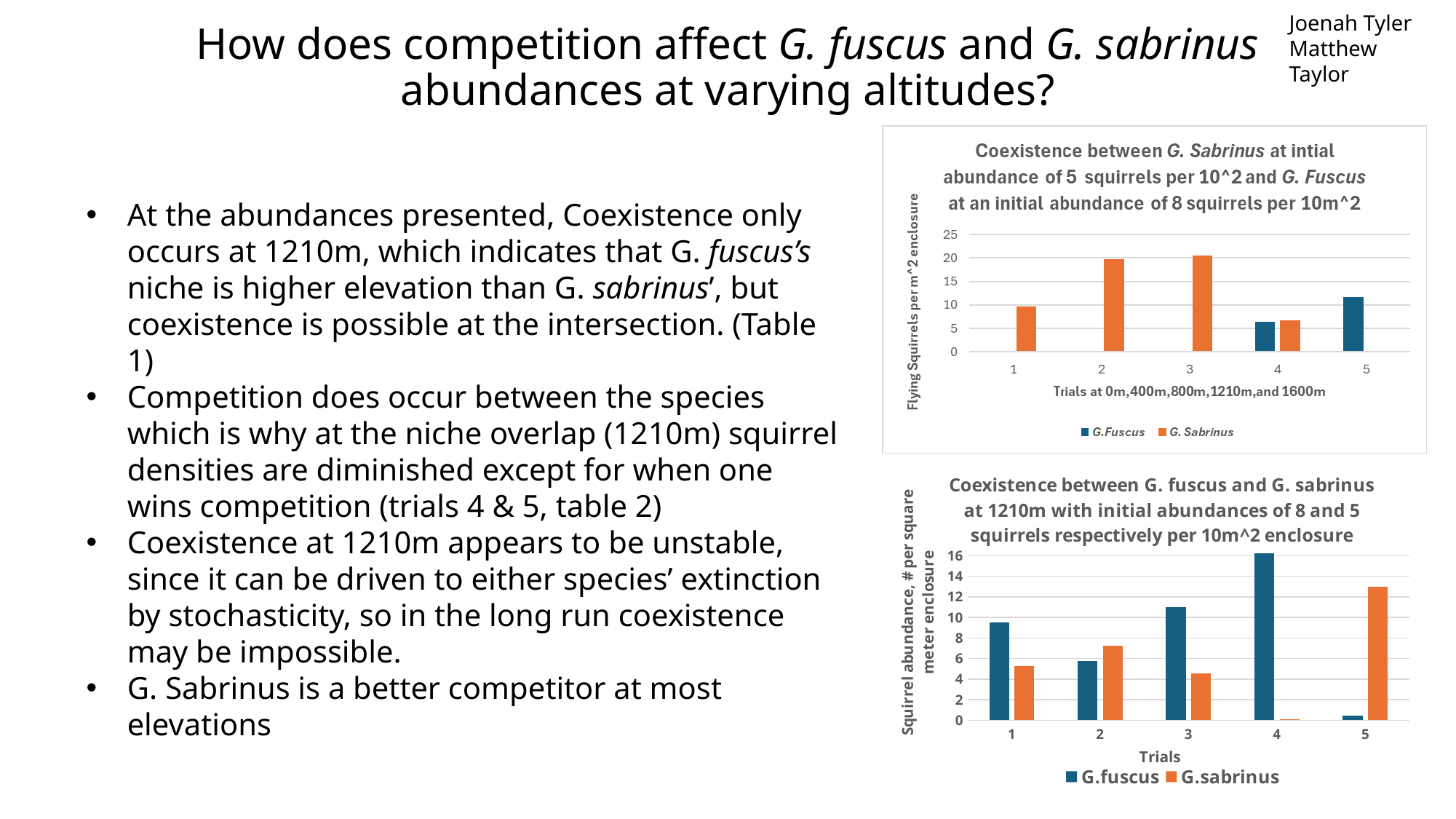
In the top chart, is the value for G. Sabrinus at trial 2 greater or less than 15? greater In the top chart, which trial has the highest G. Sabrinus value? 3 In the bottom chart, which series has the larger value at trial 3, G.fuscus or G.sabrinus? G.fuscus How many series does the legend of the top chart list? 2 How many trials are shown on the x axis of the bottom chart? 5 In the top chart, is the value for G.Fuscus at trial 4 greater or less than 10? less What is the x-axis title of the bottom chart? Trials What kind of chart is the top chart on the slide? bar chart In the bottom chart, which trial has the highest G.fuscus value? 4 In the bottom chart, which trial has the lowest G.sabrinus value? 4 In the top chart, which series has the larger value at trial 5, G.Fuscus or G. Sabrinus? G.Fuscus In the bottom chart, is the value for G.sabrinus at trial 5 greater or less than 12? greater